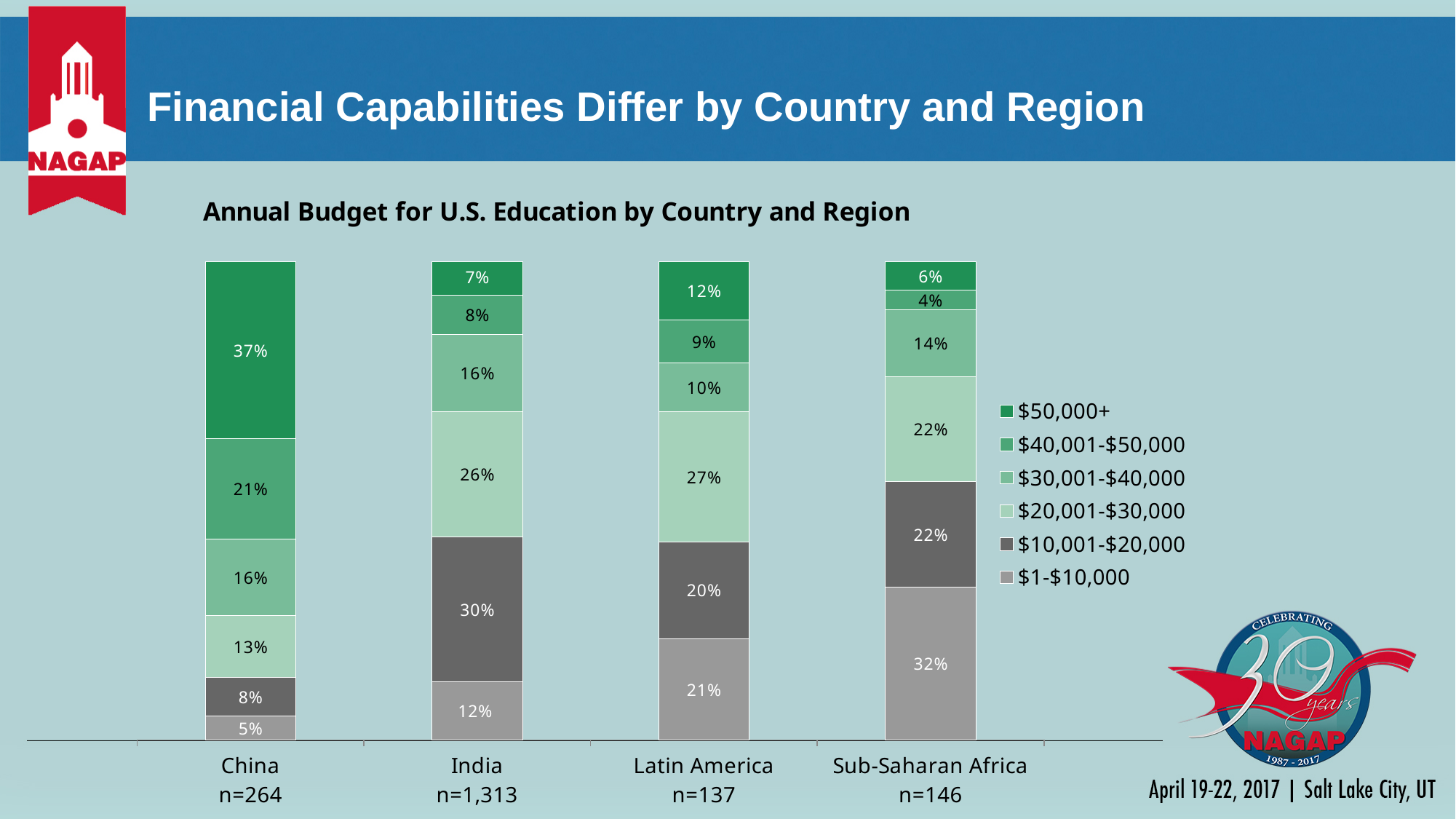
What percentage of respondents from India have an annual budget of $10,001-$20,000? 30% What percentage of respondents from Sub-Saharan Africa have an annual budget of $1-$10,000? 32% How many countries or regions are shown on the x axis? 4 What percentage of respondents from China have an annual budget of $50,000+? 37% How many budget ranges does the legend list? 6 Which country or region has the lowest share of respondents with a $40,001-$50,000 annual budget? Sub-Saharan Africa What kind of chart is shown on the slide? Stacked bar chart Which country or region has the highest share of respondents with a $50,000+ annual budget? China What percentage of respondents from Latin America have an annual budget of $20,001-$30,000? 27% What is the difference between the $50,000+ share for China and the $50,000+ share for India? 30% Which is larger: the $1-$10,000 share for Latin America or the $1-$10,000 share for India? Latin America What is the sample size (n) shown for India? n=1,313